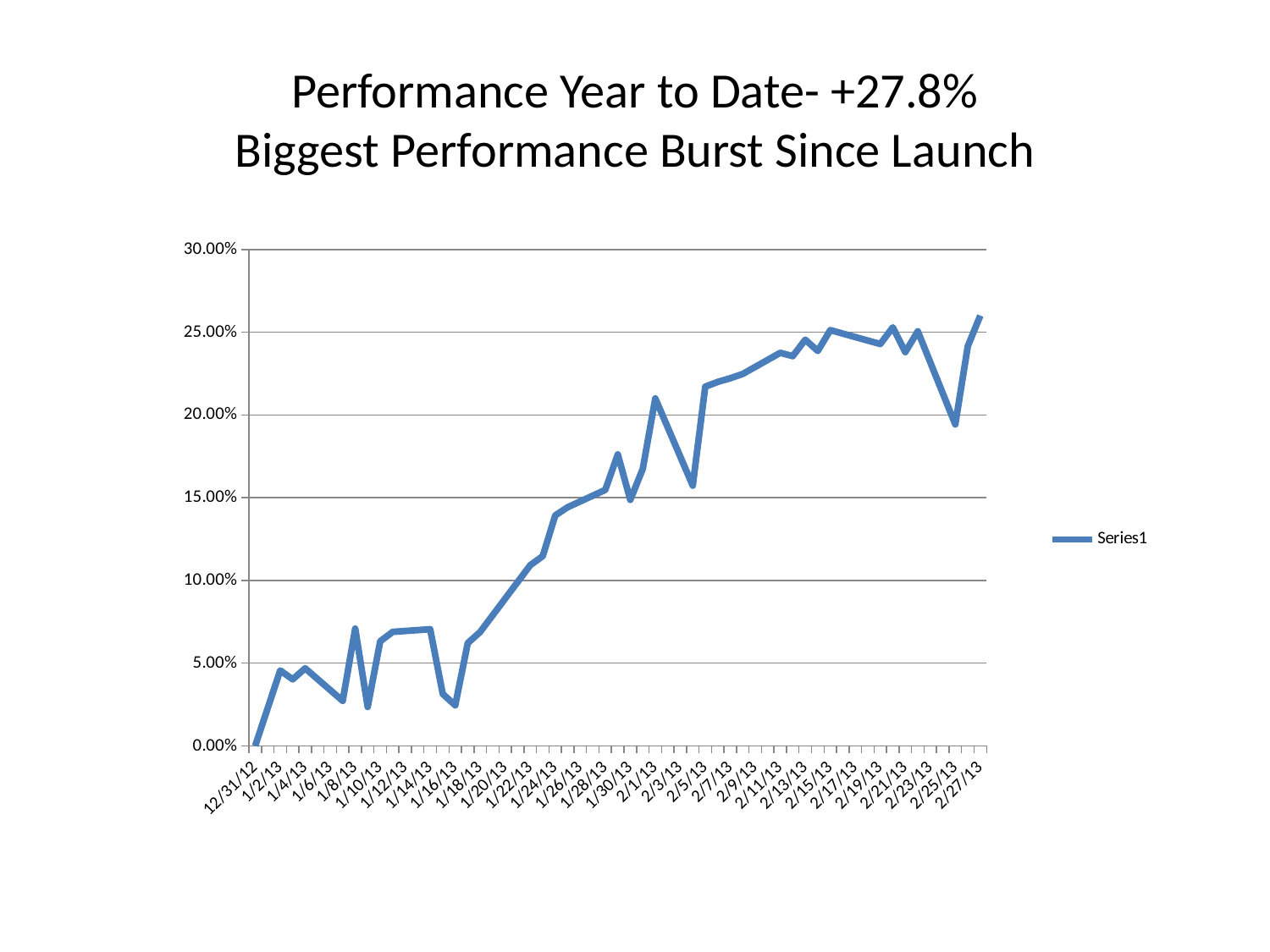
What is the title of the chart on the slide? Performance Year to Date- +27.8% Biggest Performance Burst Since Launch Is the value for 2/27/13 greater or less than 25.00%? greater Which date has the lowest value? 12/31/12 Which is larger, the value for 1/8/13 or the value for 1/10/13? 1/8/13 What is the value for 12/31/12? 0.00% Is the value for 1/16/13 greater or less than 5.00%? less What kind of chart is shown on the slide? line chart Do the values generally rise or fall from 12/31/12 to 2/27/13? rise What is the name of the series shown in the legend? Series1 Is the value for 2/11/13 greater or less than 20.00%? greater How many series does the legend list? 1